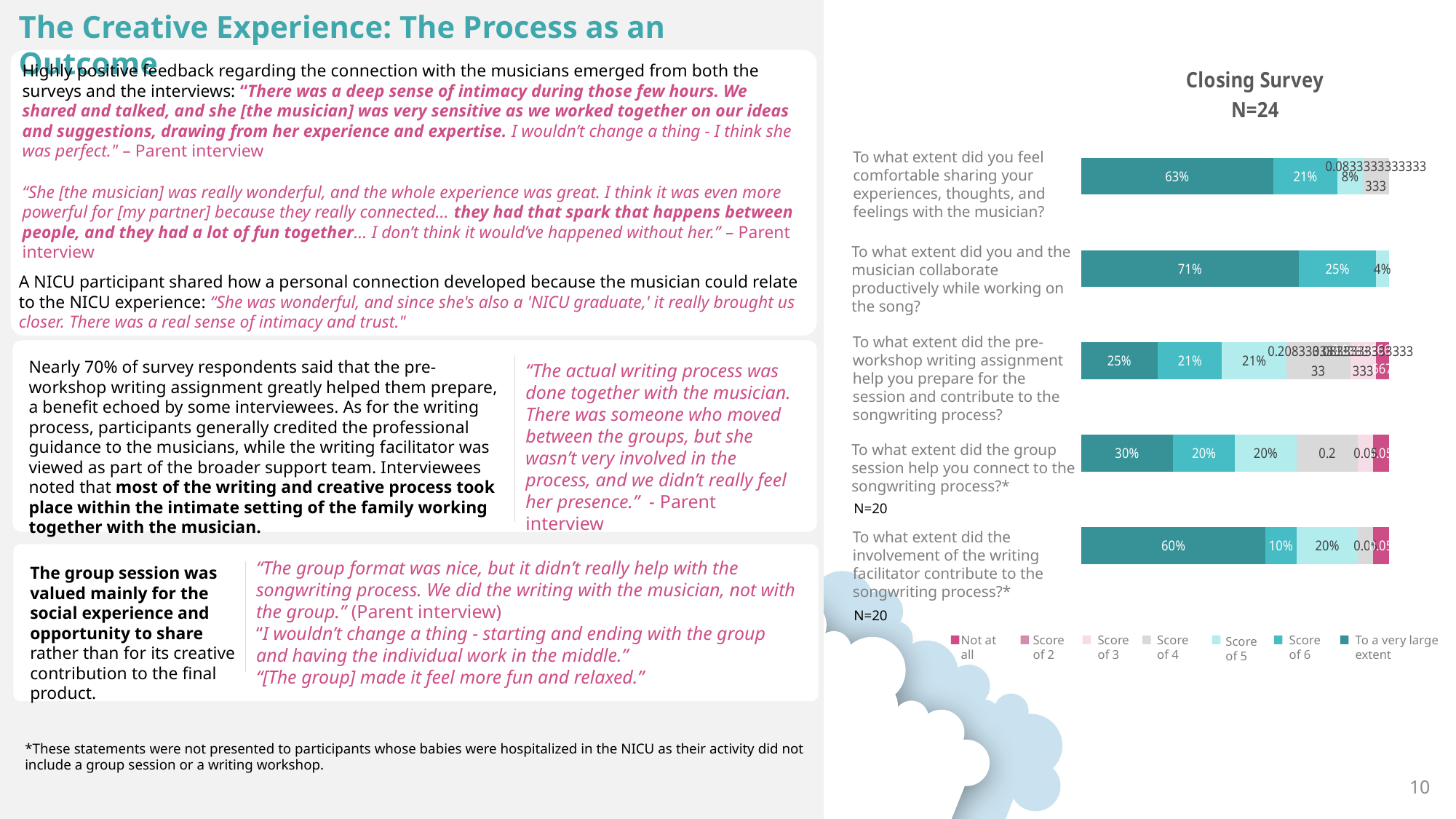
In the Closing Survey chart, which survey question has the highest share of 'To a very large extent' responses? To what extent did you and the musician collaborate productively while working on the song? In the Closing Survey chart, what percentage answered 'To a very large extent' for the involvement of the writing facilitator contributing to the songwriting process? 60% In the Closing Survey chart, what percentage answered 'To a very large extent' for feeling comfortable sharing experiences, thoughts, and feelings with the musician? 63% How many series does the legend of the Closing Survey chart list? 7 What is the title of the chart on the right side of the slide? Closing Survey N=24 In the Closing Survey chart, what percentage answered 'To a very large extent' for 'To what extent did you and the musician collaborate productively while working on the song?' 71% How many survey questions (categories) are plotted in the Closing Survey chart? 5 In the Closing Survey chart, what percentage gave a 'Score of 6' for collaborating productively with the musician? 25% What kind of chart is shown on the right side of the slide under 'Closing Survey'? Stacked bar chart In the Closing Survey chart, which is larger: the 'To a very large extent' share for comfortable sharing with the musician or for collaborating productively with the musician? Collaborating productively with the musician In the Closing Survey chart, what is the difference in percentage points between the 'To a very large extent' share for collaborating productively (71%) and for comfortable sharing (63%)? 8 percentage points In the Closing Survey chart, which survey question has the lowest share of 'To a very large extent' responses? To what extent did the pre-workshop writing assignment help you prepare for the session and contribute to the songwriting process?